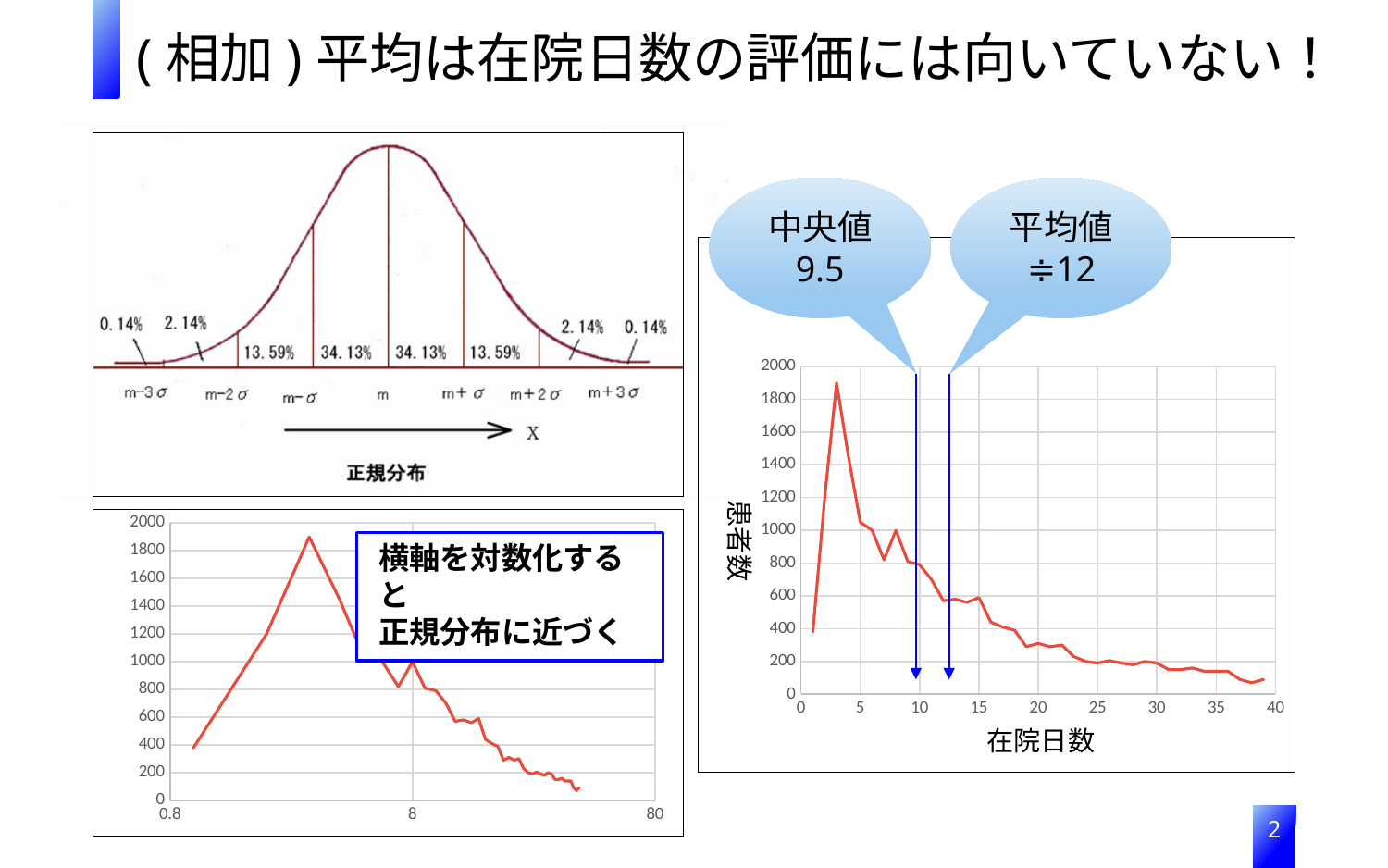
On the right chart, what is the median (中央値) value shown in the callout? 9.5 On the right chart, after the peak near 在院日数 3, do the values rise or fall as 在院日数 increases? fall On the right chart, is the peak value of the line (around 在院日数 3) greater or less than 1800? greater On the right chart, what is the label of the x axis? 在院日数 On the right chart, what is the mean (平均値) value shown in the callout? ≒12 On the right chart, what is the label of the y axis? 患者数 In the normal distribution diagram (top left), what percentage is shown between m and m+σ? 34.13% In the normal distribution diagram (top left), what percentage is shown beyond m+3σ? 0.14% What kind of chart is the chart on the right of the slide (患者数 vs 在院日数)? line chart On the right chart, is the value at 在院日数 39 greater or less than 200? less On the right chart, is the value at 在院日数 10 greater or less than 600? greater In the normal distribution diagram (top left), what percentage is shown between m+σ and m+2σ? 13.59%